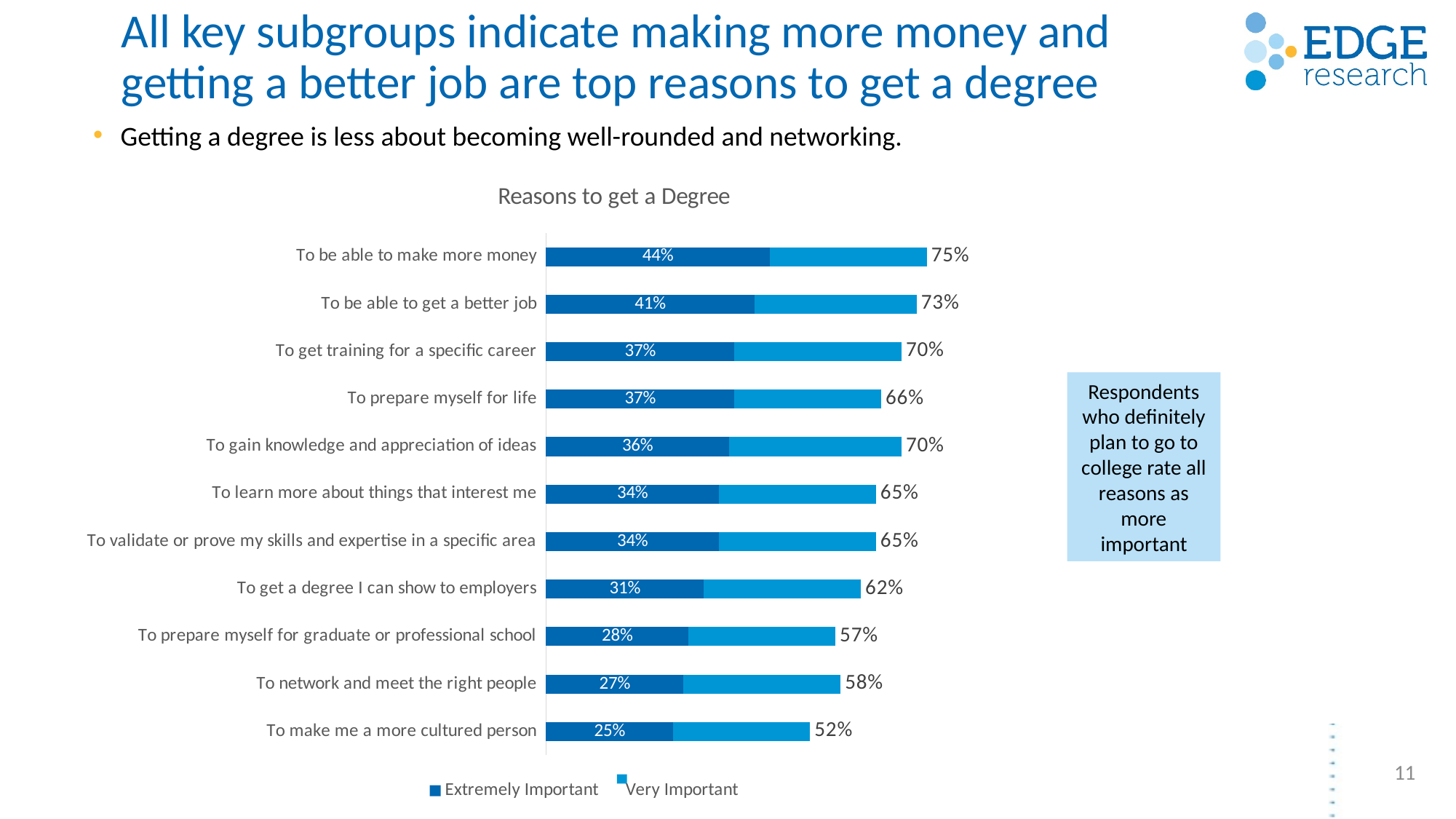
Which reason has the lowest Extremely Important percentage? To make me a more cultured person What percentage of respondents rate 'To be able to make more money' as Extremely Important? 44% How many reasons are listed in the chart? 11 Which reason has the highest combined percentage at the end of its bar? To be able to make more money What is the combined Extremely Important and Very Important percentage for 'To be able to get a better job'? 73% What type of chart is shown on the slide? Stacked bar chart Which series is shown in the darker blue colour in the chart? Extremely Important What is the difference between the combined percentage for 'To be able to make more money' (75%) and 'To make me a more cultured person' (52%)? 23 percentage points What is the title of the chart? Reasons to get a Degree Which has a higher combined percentage: 'To prepare myself for graduate or professional school' or 'To network and meet the right people'? To network and meet the right people How many series does the legend list? 2 What is the Extremely Important percentage for 'To get a degree I can show to employers'? 31%